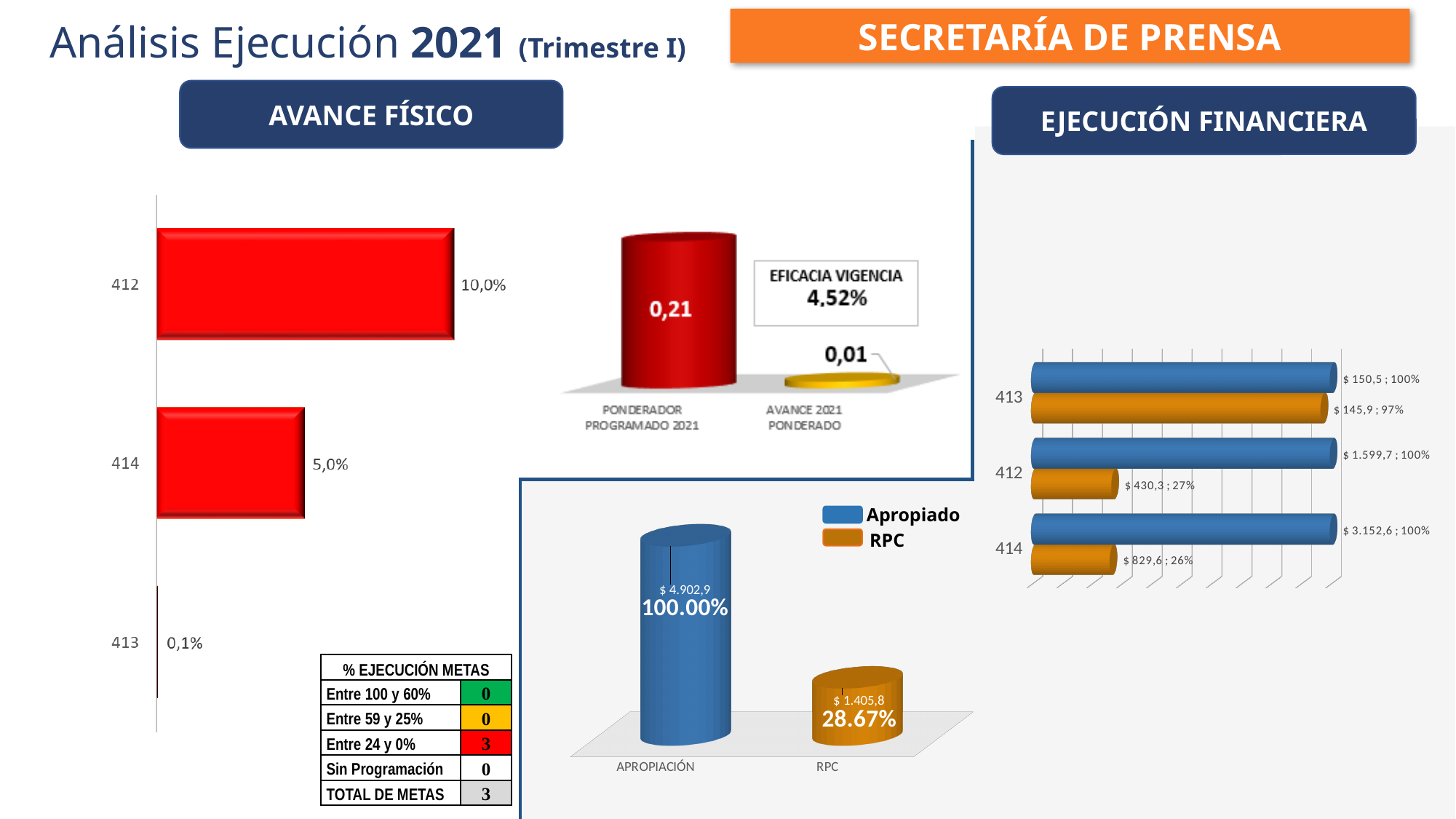
In the Avance Físico bar chart on the left, what is the value for category 413? 0,1% In the Ejecución Financiera bar chart on the right, how many series does the legend list? 2 In the Avance Físico bar chart on the left, what is the difference between the values for 412 and 414? 5,0% In the cylinder chart in the top middle, what is the value for Ponderador Programado 2021? 0,21 In the bottom-middle chart, what amount is shown for Apropiación? $ 4.902,9 In the Avance Físico bar chart on the left, which category has the lowest value? 413 In the bottom-middle chart, what percentage is shown for RPC? 28.67% In the cylinder chart in the top middle, what is the value for Avance 2021 Ponderado? 0,01 In the Avance Físico bar chart on the left, how many categories are plotted? 3 In the Ejecución Financiera bar chart on the right, what is the RPC value for category 412? $ 430,3 ; 27% In the Avance Físico bar chart on the left, what is the value for category 412? 10,0% In the Avance Físico bar chart on the left, which category has the highest value? 412